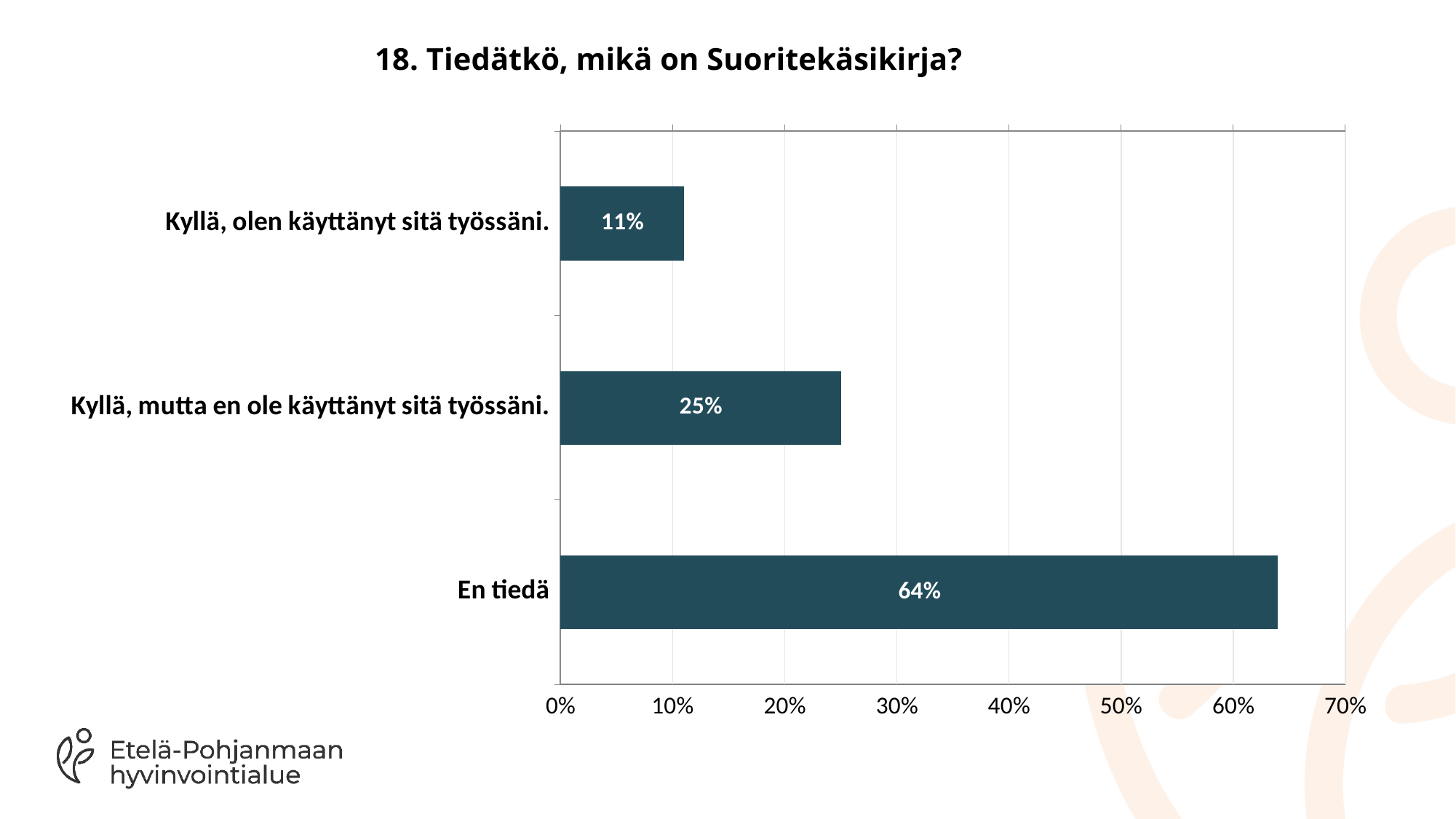
What kind of chart is shown on the slide? bar chart What is the difference between the values for "Kyllä, mutta en ole käyttänyt sitä työssäni." and "Kyllä, olen käyttänyt sitä työssäni."? 14% How many categories are shown in the chart? 3 Which category has the lowest value? Kyllä, olen käyttänyt sitä työssäni. What is the difference between the values for "En tiedä" and "Kyllä, mutta en ole käyttänyt sitä työssäni."? 39% Is the value for "En tiedä" greater or less than 60%? greater What is the value for "Kyllä, olen käyttänyt sitä työssäni."? 11% What is the value for "En tiedä"? 64% Which category has the highest value? En tiedä What is the value for "Kyllä, mutta en ole käyttänyt sitä työssäni."? 25% What is the title of the chart? 18. Tiedätkö, mikä on Suoritekäsikirja? Which is larger: the value for "Kyllä, olen käyttänyt sitä työssäni." or for "Kyllä, mutta en ole käyttänyt sitä työssäni."? Kyllä, mutta en ole käyttänyt sitä työssäni.